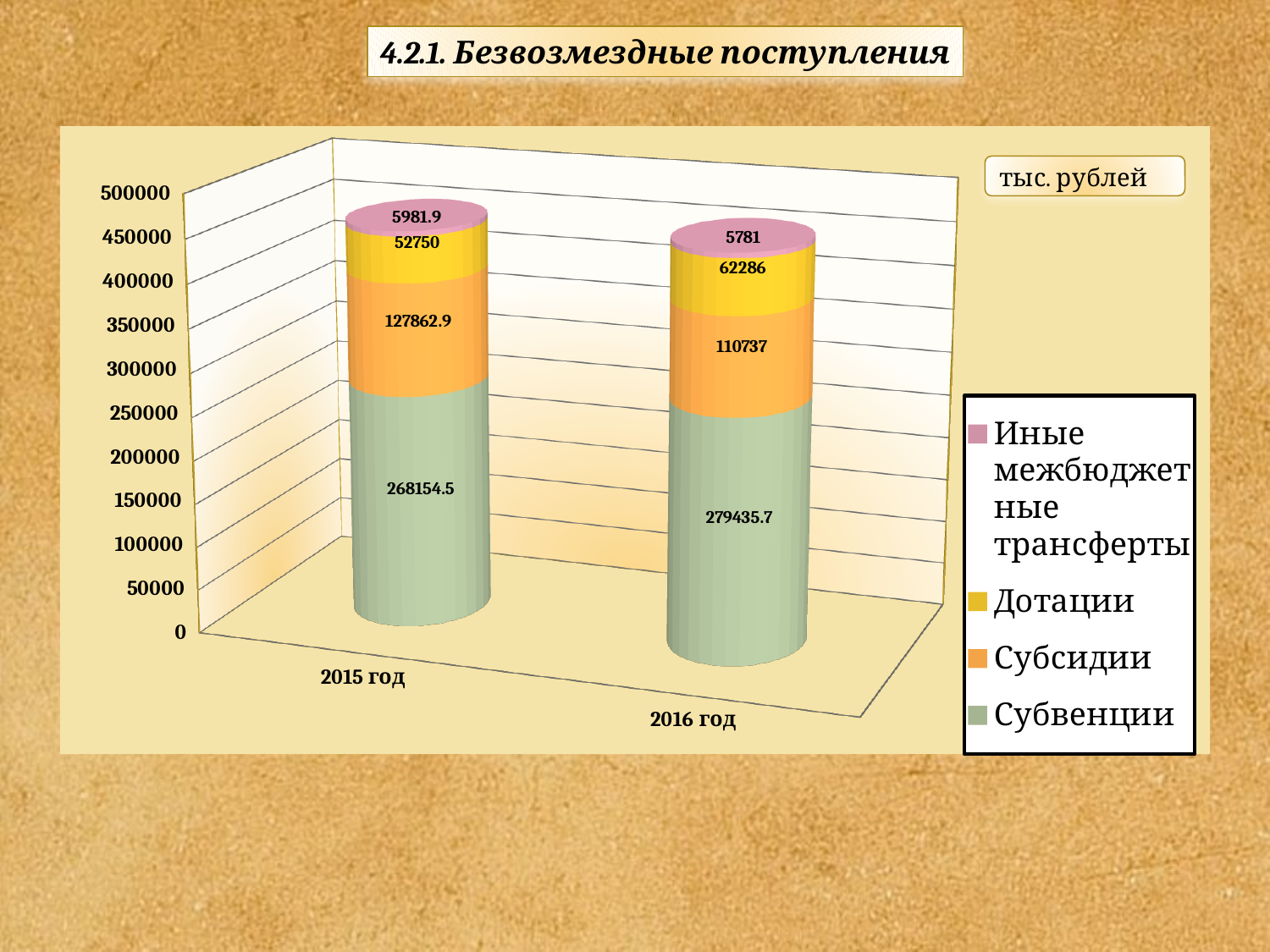
What is the value of Субсидии for 2016 год? 110737 How many series does the legend list? 4 What kind of chart is shown on the slide? Stacked bar chart What is the total of the stacked bar for 2016 год? 458239.7 Which series has the smallest value in 2015 год? Иные межбюджетные трансферты Which series has the largest value in 2016 год? Субвенции What unit is indicated in the box at the top right of the chart? тыс. рублей Which year has the larger Дотации value, 2015 год or 2016 год? 2016 год What is the value of Дотации for 2015 год? 52750 What is the difference between the Субсидии values for 2015 год and 2016 год? 17125.9 What is the value of Субвенции for 2015 год? 268154.5 What is the value of Иные межбюджетные трансферты for 2016 год? 5781